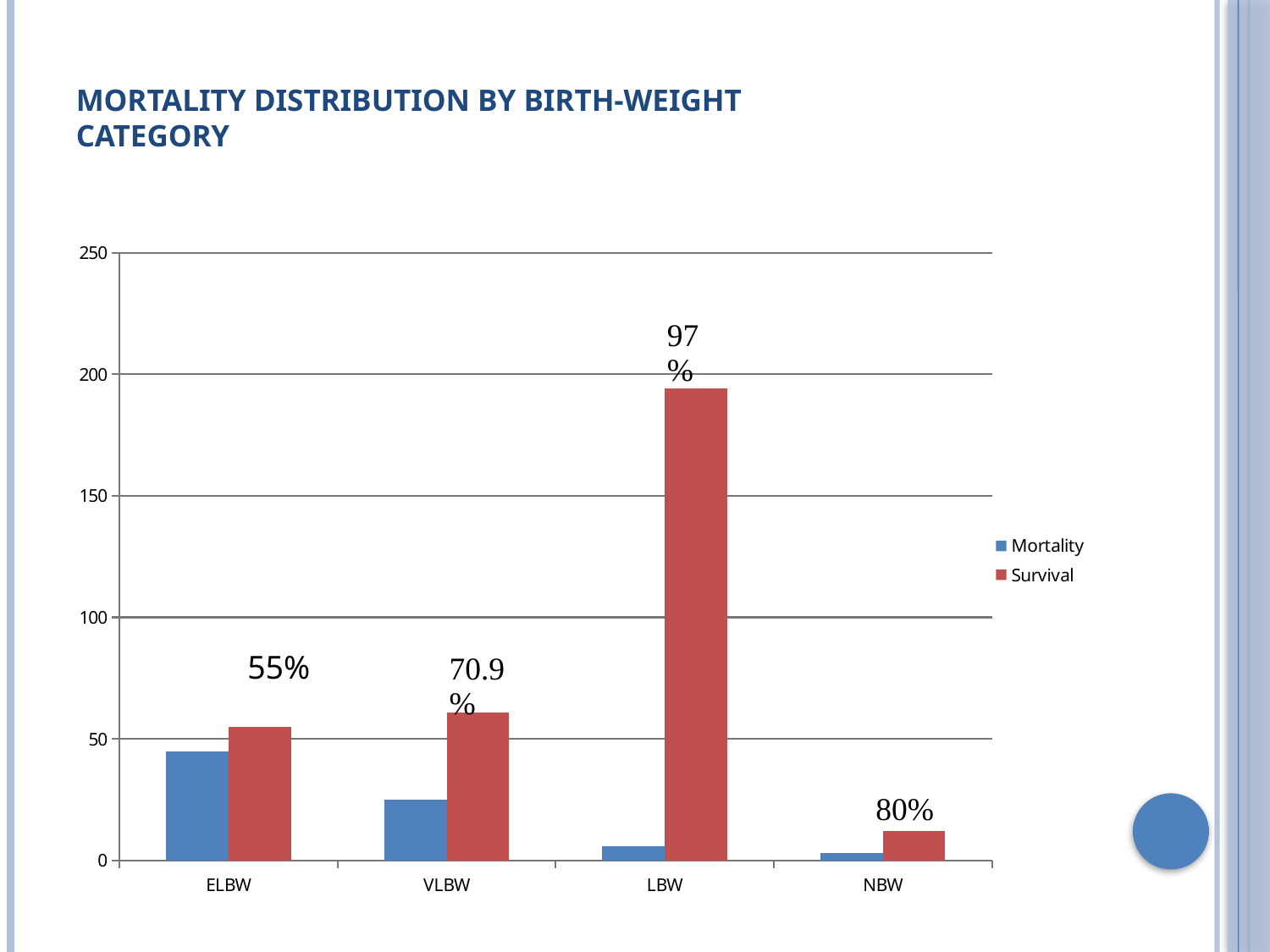
What percentage label is printed above the LBW bars? 97% Is the Mortality value for ELBW greater or less than 50? less Is the Survival value for LBW greater or less than 150? greater Do the Mortality values rise or fall moving from ELBW to NBW along the x axis? fall Is the Survival value for VLBW greater or less than 50? greater How many series does the legend list? 2 Which birth-weight category has the highest Mortality value? ELBW Which birth-weight category has the highest Survival value? LBW What kind of chart is shown on the slide? bar chart Which birth-weight category has the lowest Survival value? NBW How many birth-weight categories are shown on the x axis? 4 For ELBW, which is larger: the Mortality bar or the Survival bar? Survival